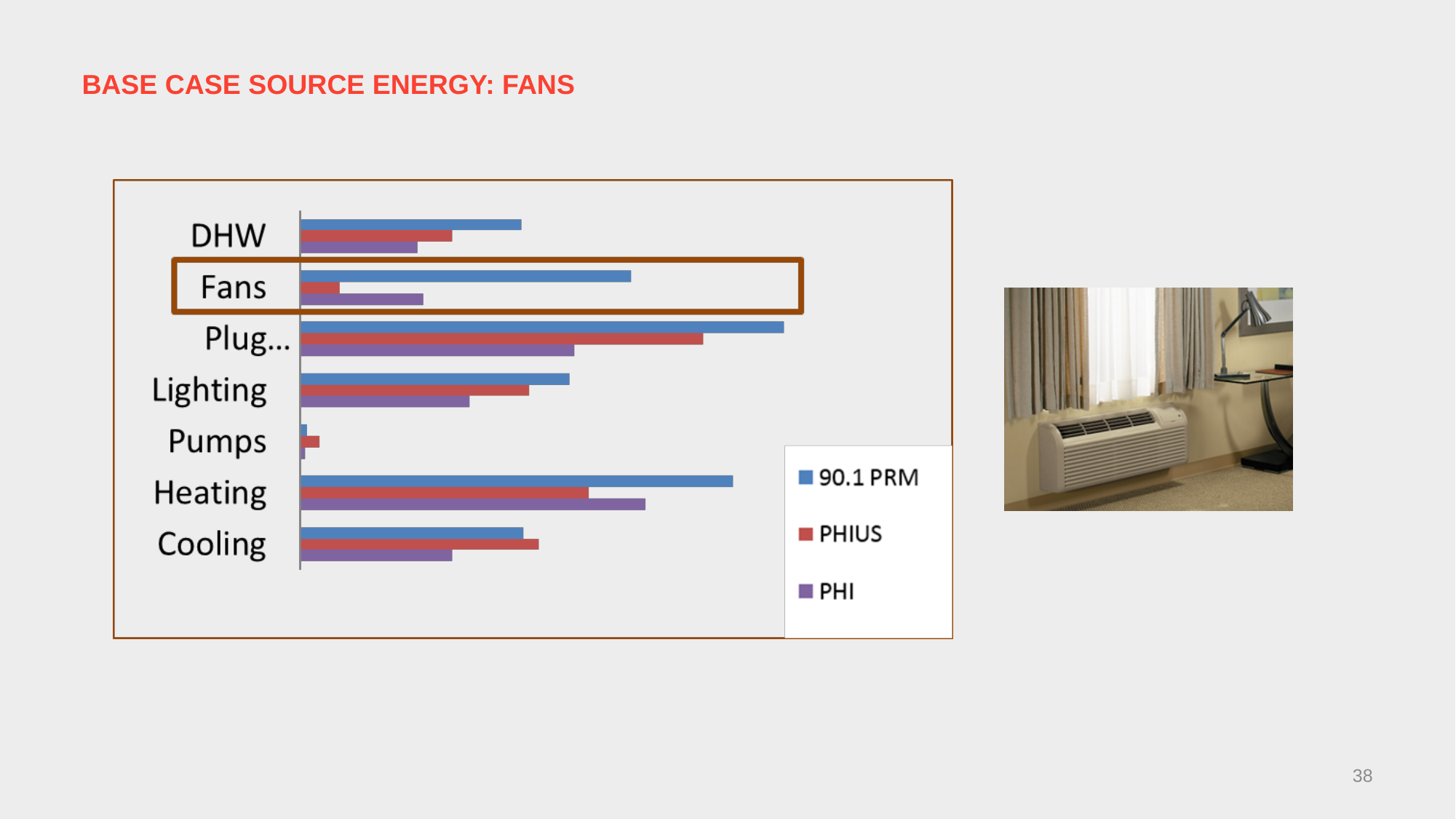
How many series does the chart's legend list? 3 Which category has the highest PHIUS value? Plug... How many categories are plotted on the chart? 7 For Heating, which series has the larger value, PHIUS or PHI? PHI For Fans, which series has the larger value, 90.1 PRM or PHIUS? 90.1 PRM What kind of chart is shown on the slide? Bar chart Which category on the chart is highlighted with a brown box? Fans For Cooling, which series has the larger value, PHIUS or PHI? PHIUS Which category has the lowest 90.1 PRM value? Pumps Which category has the lowest PHI value? Pumps Which category has the highest 90.1 PRM value? Plug... What colour represents the PHI series in the legend? Purple